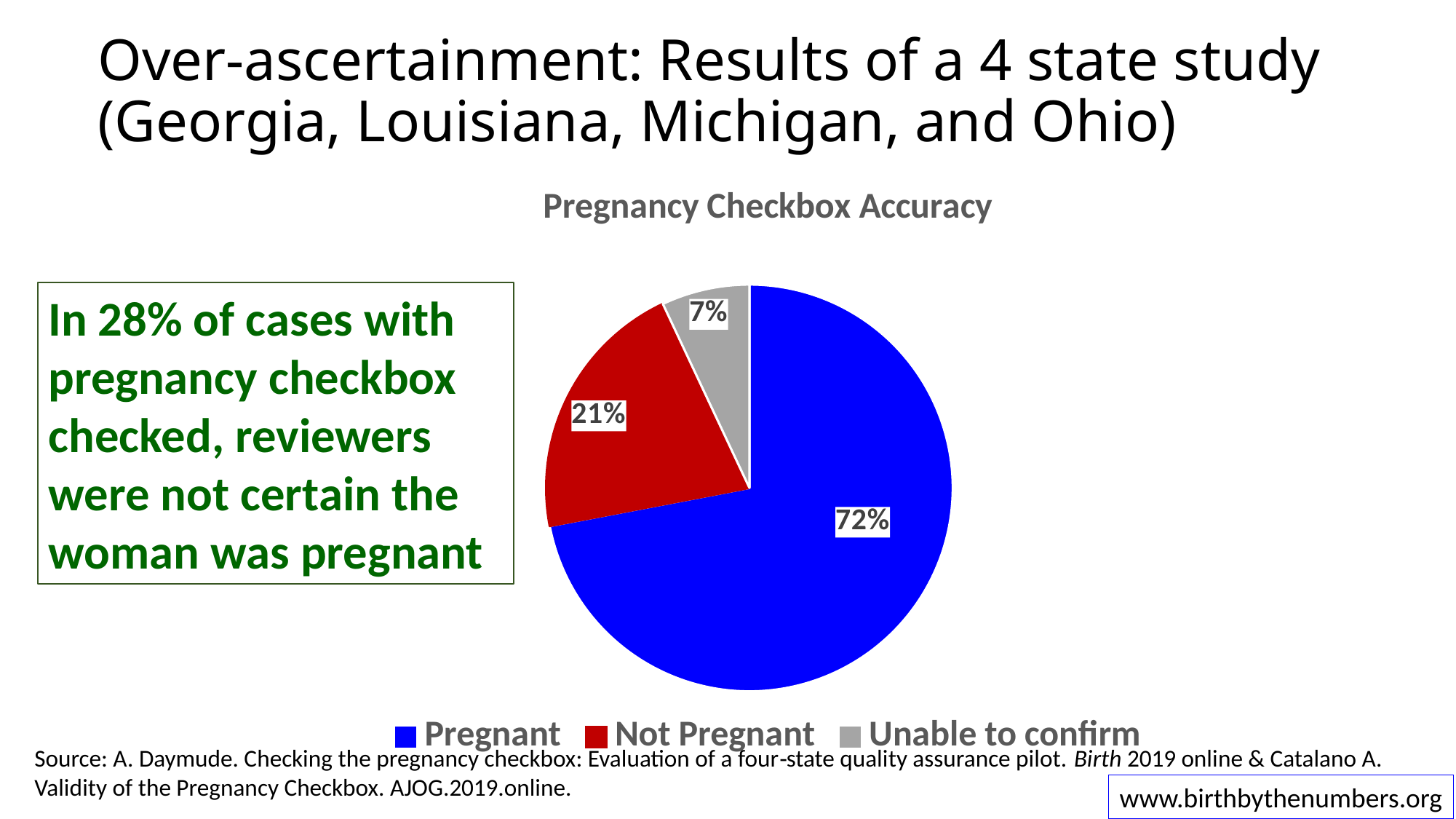
How many slices does the pie chart have? 3 Which category has the largest slice of the pie? Pregnant What is the difference in percentage points between the Not Pregnant and Unable to confirm slices? 14 What share of the pie is labelled Pregnant? 72% What colour is the Not Pregnant slice? Red Which category has the smallest slice of the pie? Unable to confirm What is the difference in percentage points between the Pregnant and Not Pregnant slices? 51 What share of the pie is labelled Not Pregnant? 21% What kind of chart is shown on the slide? Pie chart What is the title of the chart? Pregnancy Checkbox Accuracy Which slice is larger, Not Pregnant or Unable to confirm? Not Pregnant What share of the pie is labelled Unable to confirm? 7%